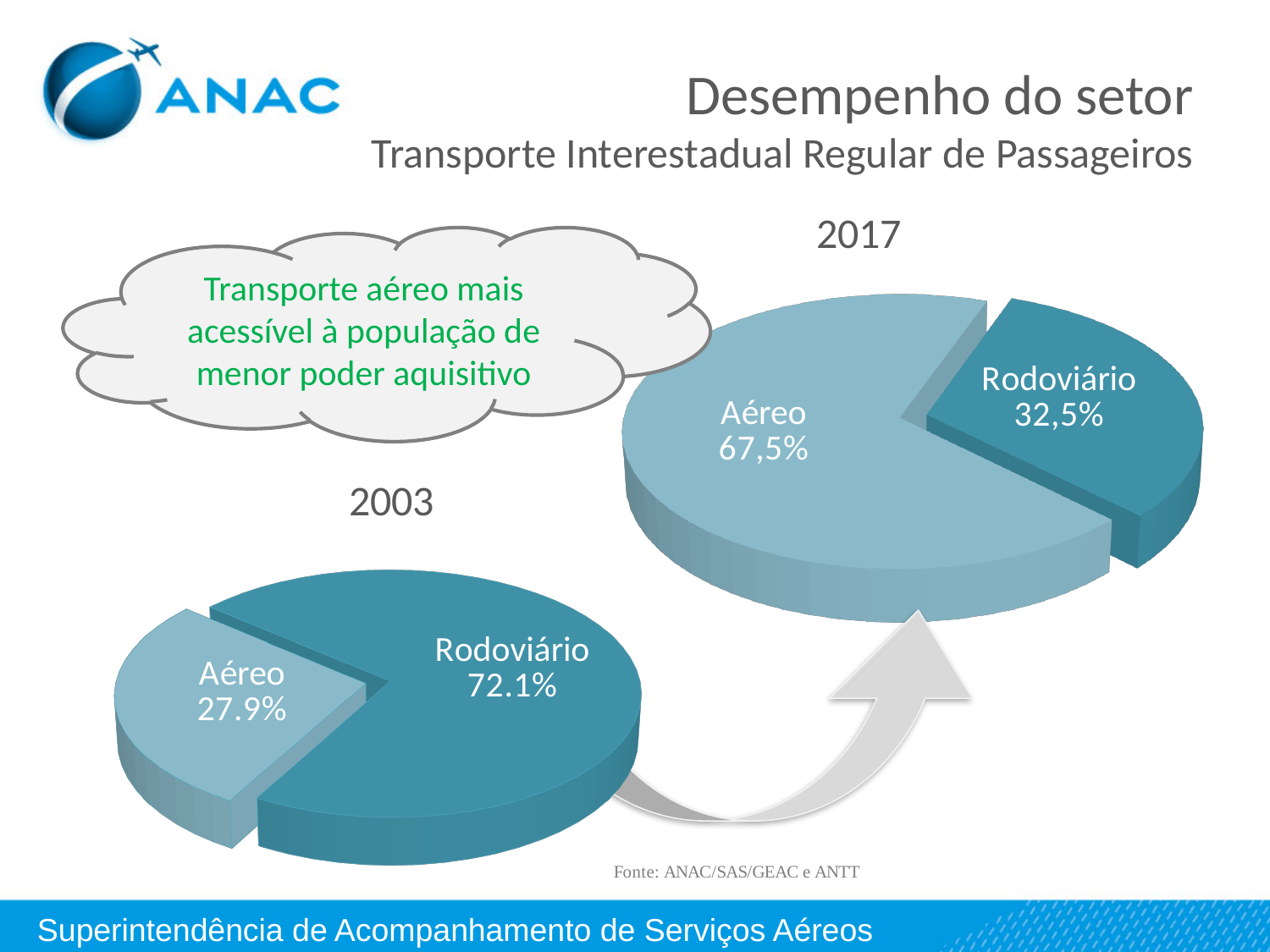
In the 2017 pie chart, what is the difference between the Aéreo and Rodoviário shares? 35% What type of chart is used for the 2017 data? Pie chart In the 2003 pie chart, what share does Aéreo have? 27.9% How many pie charts are shown on the slide? 2 In the 2017 pie chart, what share does Aéreo have? 67,5% In the 2017 pie chart, what share does Rodoviário have? 32,5% In the 2003 pie chart, what share does Rodoviário have? 72.1% In the 2017 pie chart, which category has the smallest slice? Rodoviário In the 2003 pie chart, what is the difference between the Rodoviário and Aéreo shares? 44.2% In the 2017 pie chart, which is larger, Aéreo or Rodoviário? Aéreo In the 2003 pie chart, which category has the largest slice? Rodoviário How many slices does the 2003 pie chart have? 2